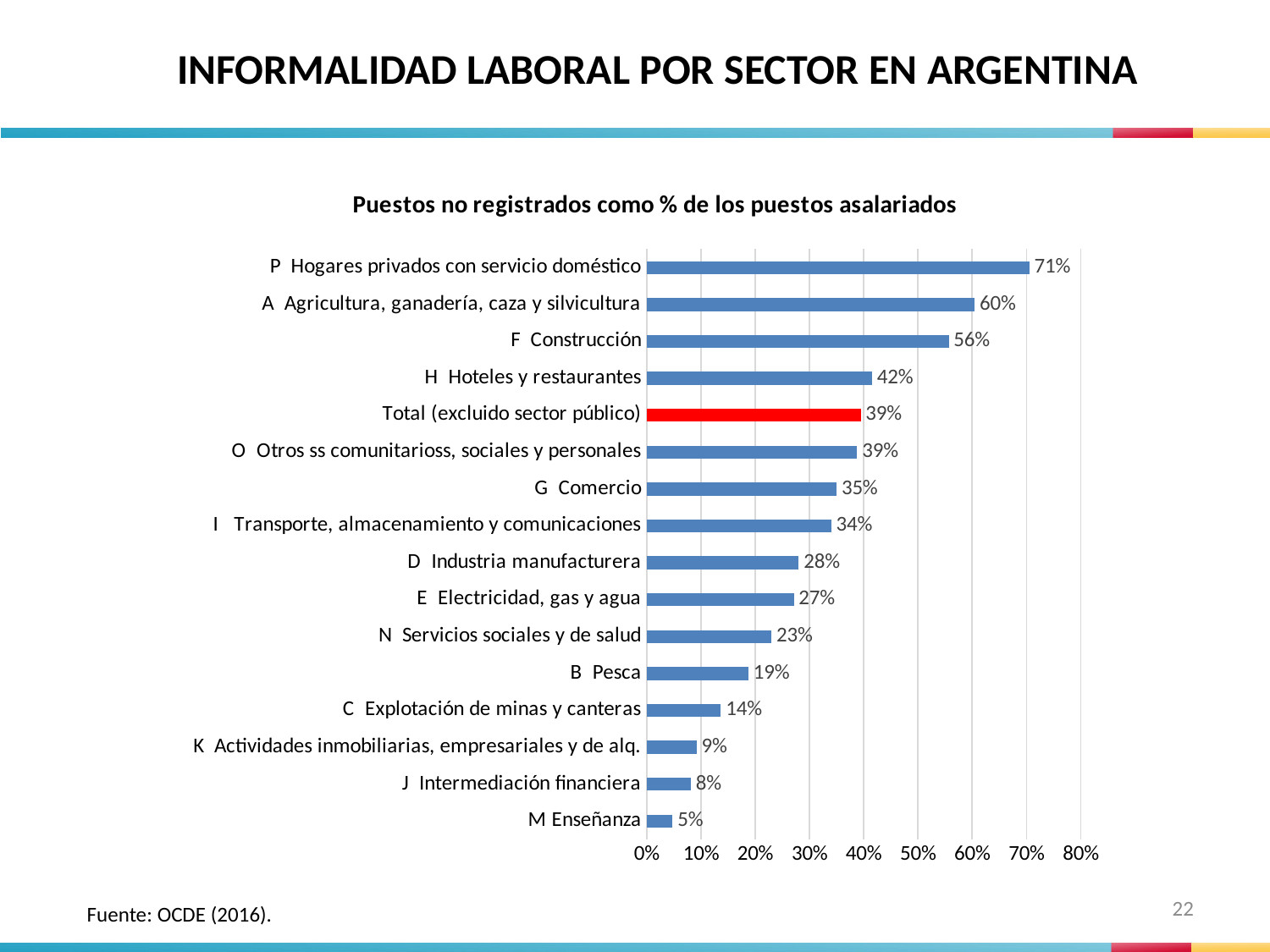
Which is larger, the value for D Industria manufacturera or the value for N Servicios sociales y de salud? D Industria manufacturera What is the value for B Pesca? 19% Which category has the highest value? P Hogares privados con servicio doméstico What is the value for F Construcción? 56% Is the value for G Comercio greater or less than 30%? greater What is the difference between the values for A Agricultura, ganadería, caza y silvicultura and H Hoteles y restaurantes? 18% Which bar is coloured red instead of blue? Total (excluido sector público) What is the title of the chart? Puestos no registrados como % de los puestos asalariados Which category has the lowest value? M Enseñanza What is the value for Total (excluido sector público)? 39% How many categories (bars) are shown in the chart? 16 What kind of chart is shown on the slide? Bar chart